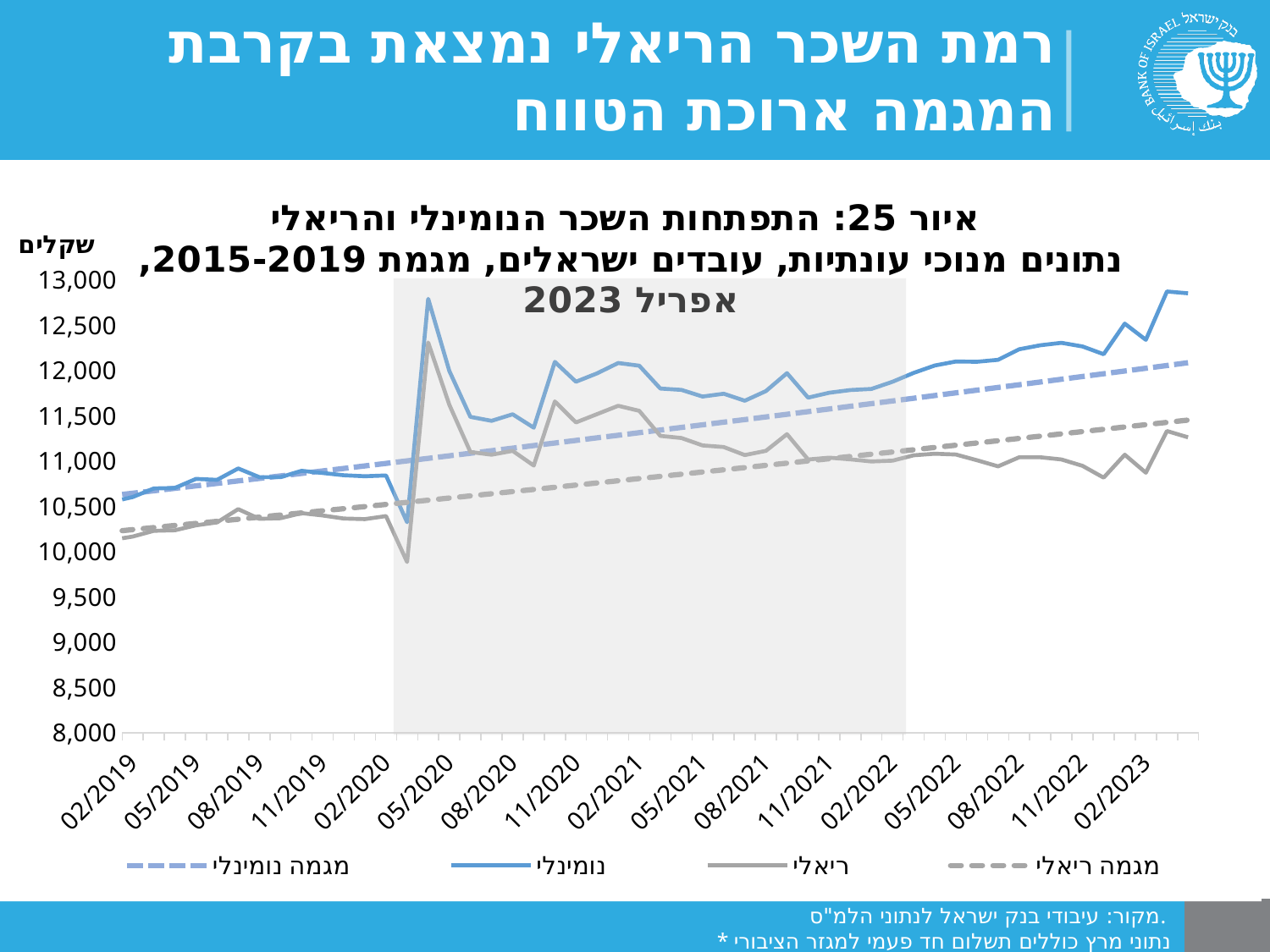
Which series is higher at 02/2022, מגמה נומינלי or מגמה ריאלי? מגמה נומינלי What unit is shown on the y axis of the chart? שקלים Does the נומינלי series rise or fall overall from 02/2019 to 02/2023? rise What kind of chart is shown on the slide? line chart Is the peak of the נומינלי series in 2020 greater or less than 12,500? greater Is the value of the ריאלי series at 02/2023 greater or less than 11,500? less Is the lowest point of the ריאלי series, in early 2020, greater or less than 10,000? less Which series is higher at 02/2023, נומינלי or ריאלי? נומינלי What is the title of the chart? איור 25: התפתחות השכר הנומינלי והריאלי נתונים מנוכי עונתיות, עובדים ישראלים, מגמת 2015-2019, אפריל 2023 How many series does the legend list? 4